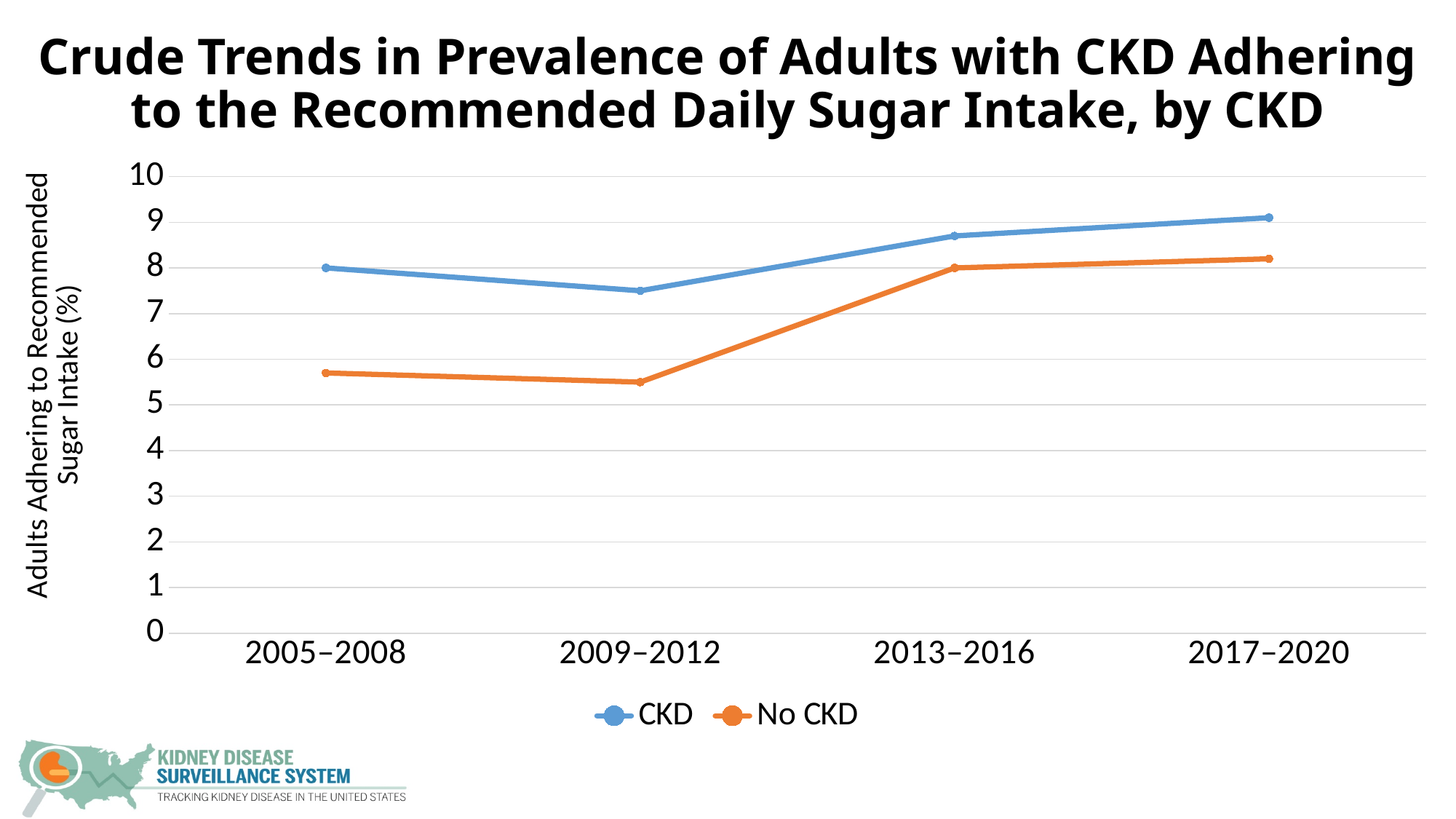
What is the value for CKD in 2005–2008? 8 In 2005–2008, which series has the larger value, CKD or No CKD? CKD Is the value for CKD in 2009–2012 greater or less than 7? greater Is the value for No CKD in 2005–2008 greater or less than 6? less Is the value for CKD in 2013–2016 greater or less than 8? greater In which period is the CKD series lowest? 2009–2012 Does the No CKD series rise or fall from 2009–2012 to 2017–2020? rise How many series does the legend list? 2 What is the value for No CKD in 2013–2016? 8 In which period is the CKD series highest? 2017–2020 What kind of chart is shown on the slide? line chart How many time periods are shown on the x axis? 4